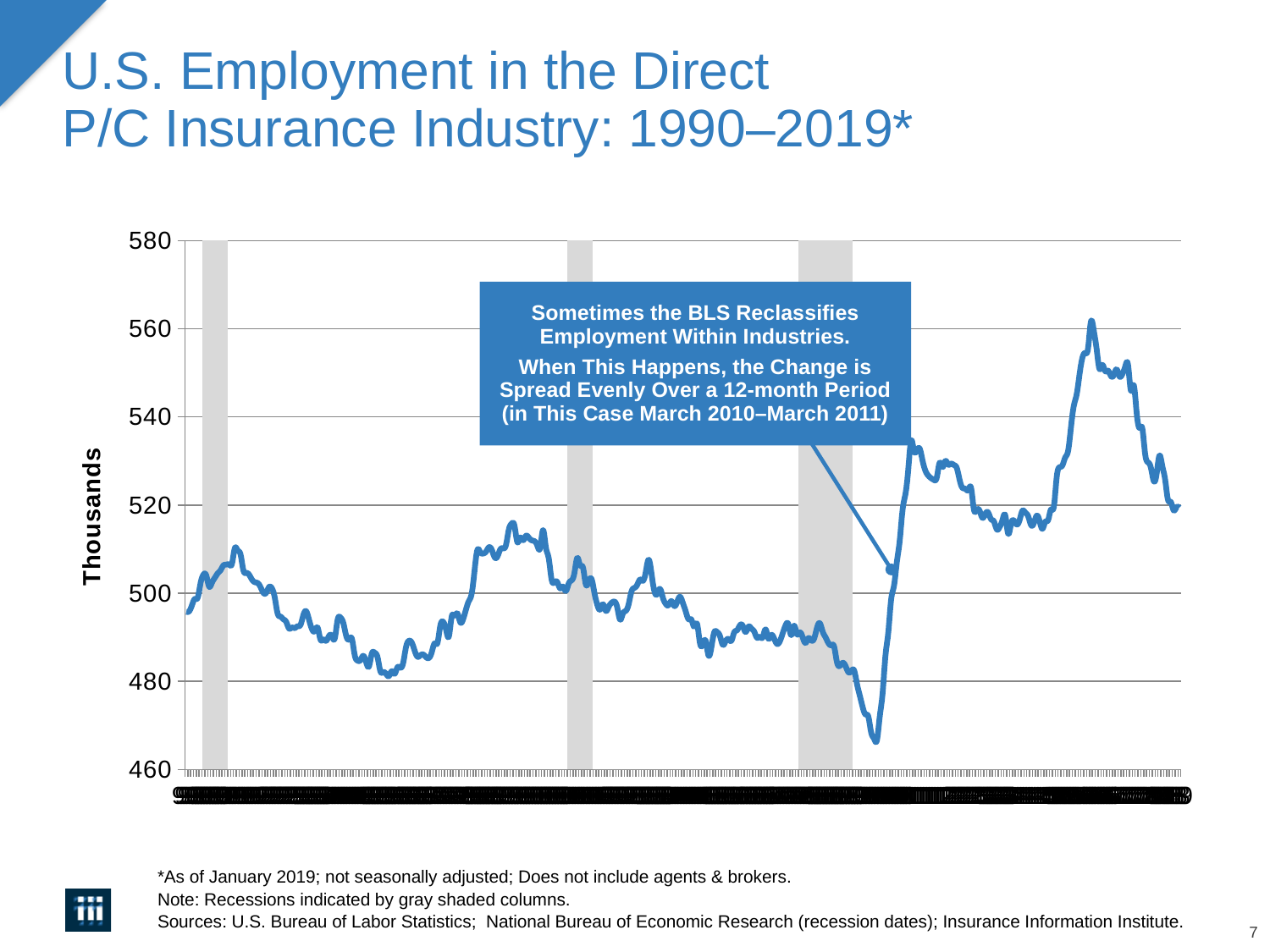
Is the lowest point of the line greater or less than 460? greater Is the lowest point of the line greater or less than 480? less What is the highest value shown on the vertical axis? 580 What is the title of the chart on the slide? U.S. Employment in the Direct P/C Insurance Industry: 1990–2019* Is the value at the right end of the line (the most recent point) greater or less than 500? greater What is the label on the vertical axis of the chart? Thousands How many gray shaded recession columns are shown on the chart? 3 What kind of chart is shown on the slide? line chart Does the line rise or fall across the third (rightmost) gray shaded recession column? fall